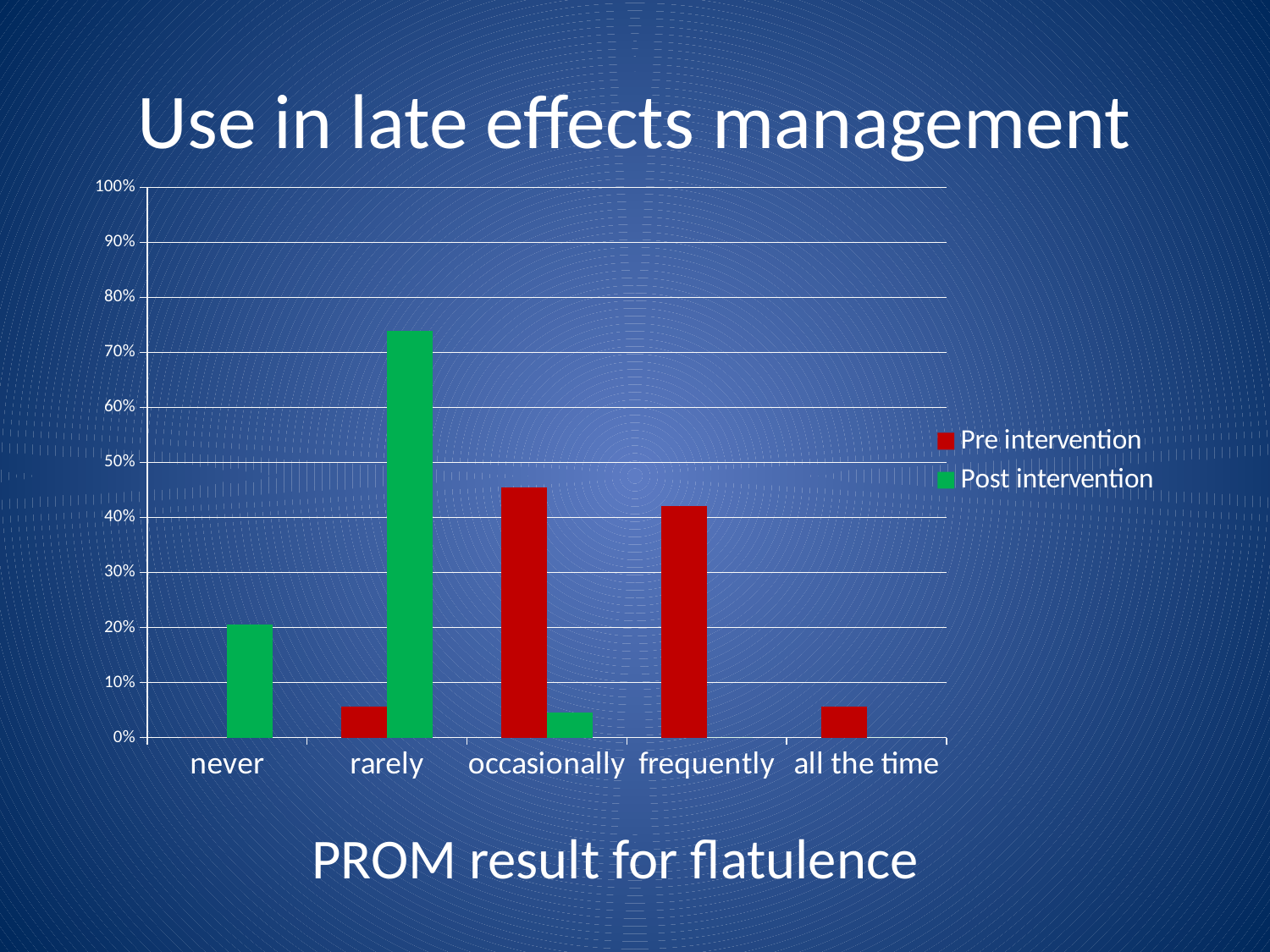
Which category has the highest Post intervention value? rarely How many series does the legend list? 2 What kind of chart is shown on the slide? bar chart Is the Pre intervention value for rarely greater or less than 10%? less How many categories are shown on the x axis? 5 For the occasionally category, which is larger: the Pre intervention value or the Post intervention value? Pre intervention Is the Pre intervention value for occasionally greater or less than 40%? greater Is the Post intervention value for rarely greater or less than 60%? greater What colour are the Post intervention bars? green For the rarely category, which is larger: the Pre intervention value or the Post intervention value? Post intervention